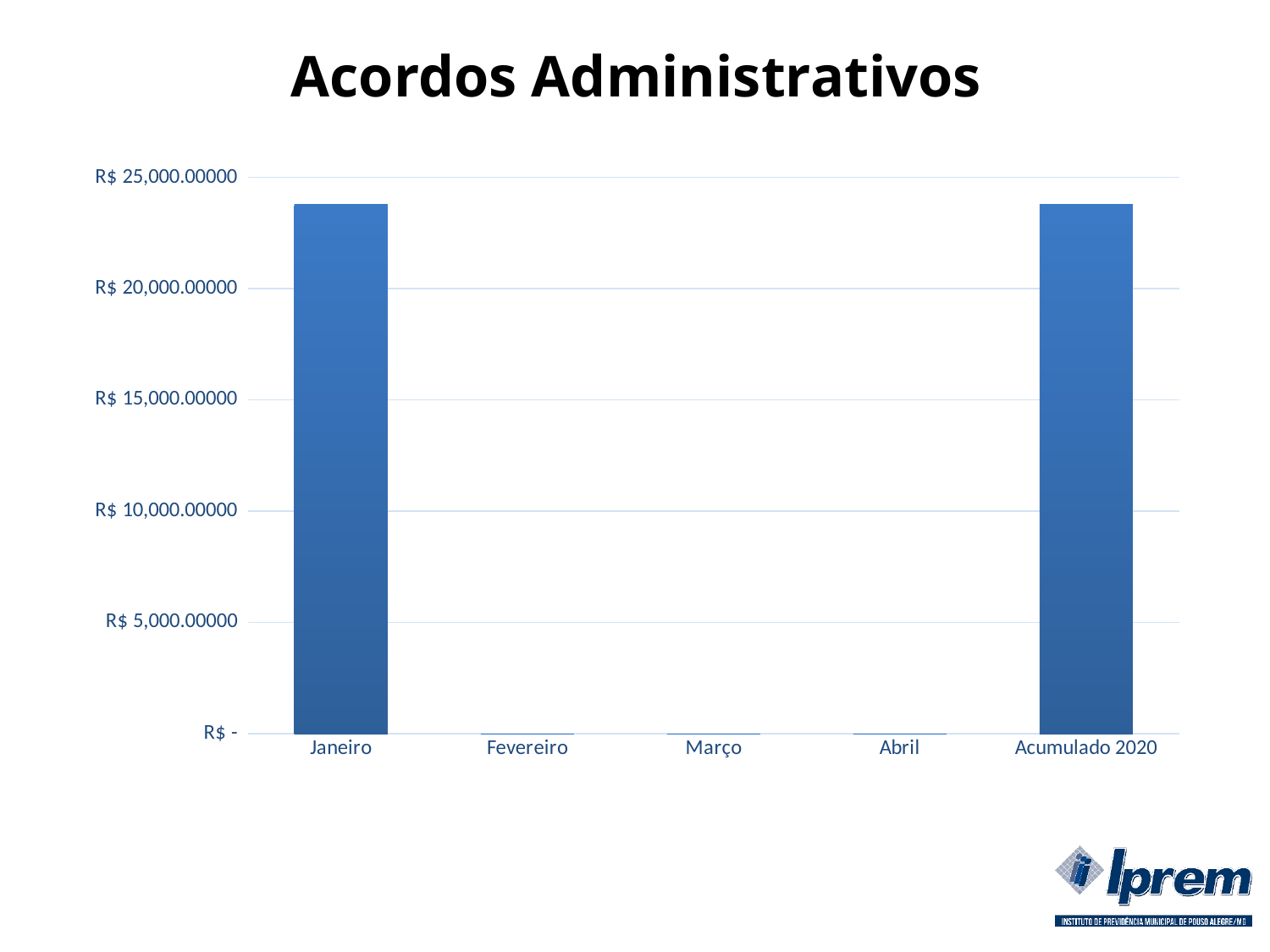
Which is larger, the value for Janeiro or the value for Fevereiro? Janeiro What is the label of the last category on the x axis? Acumulado 2020 Is the value for Abril greater or less than R$ 5,000.00000? less What is the value shown for Fevereiro? R$ - What is the title of the chart? Acordos Administrativos Is the value for Janeiro greater or less than R$ 20,000.00000? greater How many categories are shown on the x axis of the chart? 5 Which is larger, the value for Março or the value for Acumulado 2020? Acumulado 2020 Is the value for Acumulado 2020 greater or less than R$ 20,000.00000? greater Which is larger, the value for Abril or the value for Janeiro? Janeiro What kind of chart is shown on the slide? bar chart